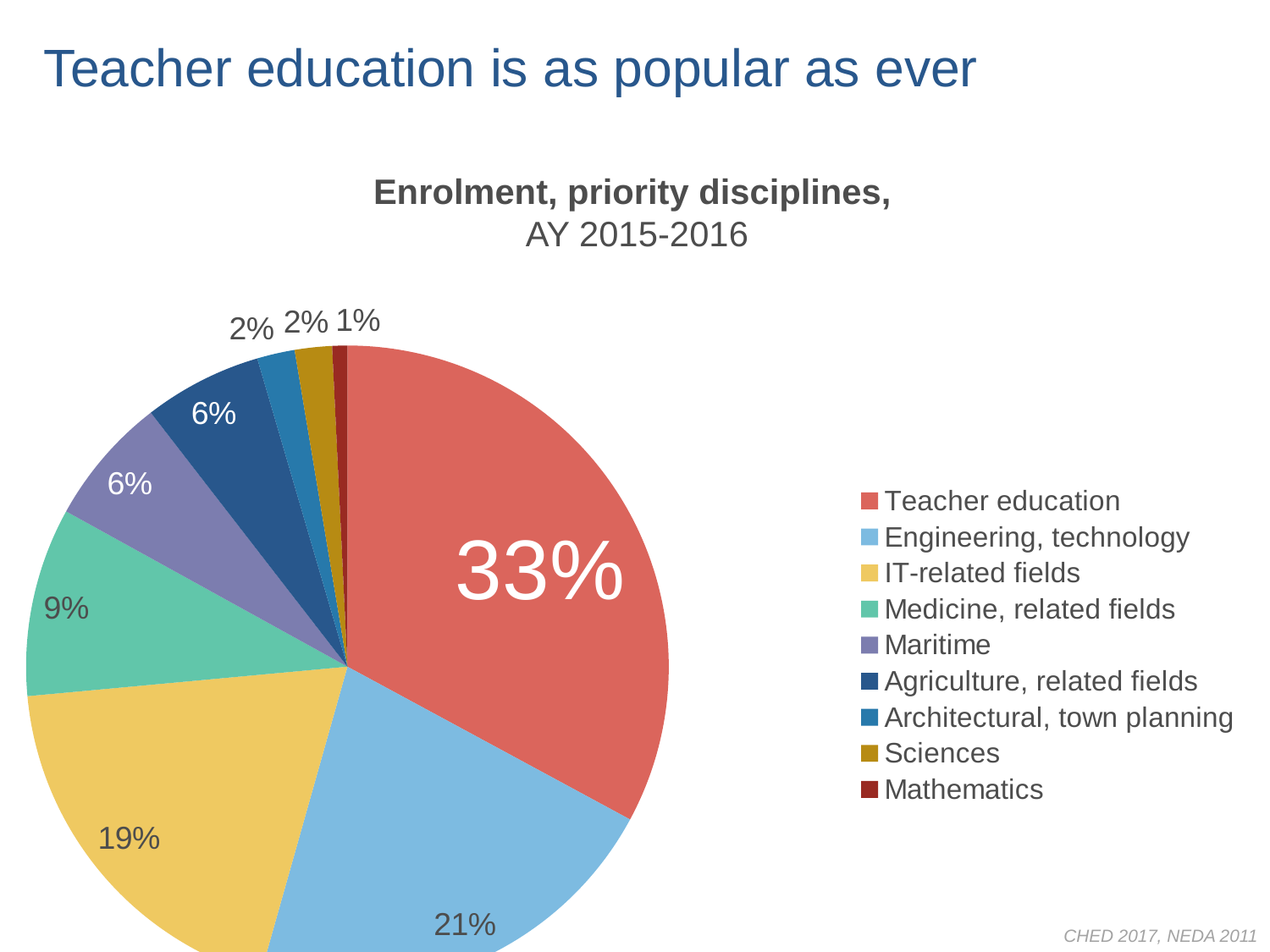
What is the difference in percentage points between Teacher education and Engineering, technology? 12 What is the value shown for IT-related fields? 19% What is the value shown for Medicine, related fields? 9% What is the title of the chart? Enrolment, priority disciplines, AY 2015-2016 Which has a larger share, IT-related fields or Medicine, related fields? IT-related fields How many disciplines are shown in the pie chart? 9 Which discipline has the largest share of enrolment? Teacher education What is the value shown for Engineering, technology? 21% Which discipline has the smallest share of enrolment? Mathematics What is the value shown for Mathematics? 1% What type of chart is shown on the slide? Pie chart What share of enrolment does Teacher education account for? 33%